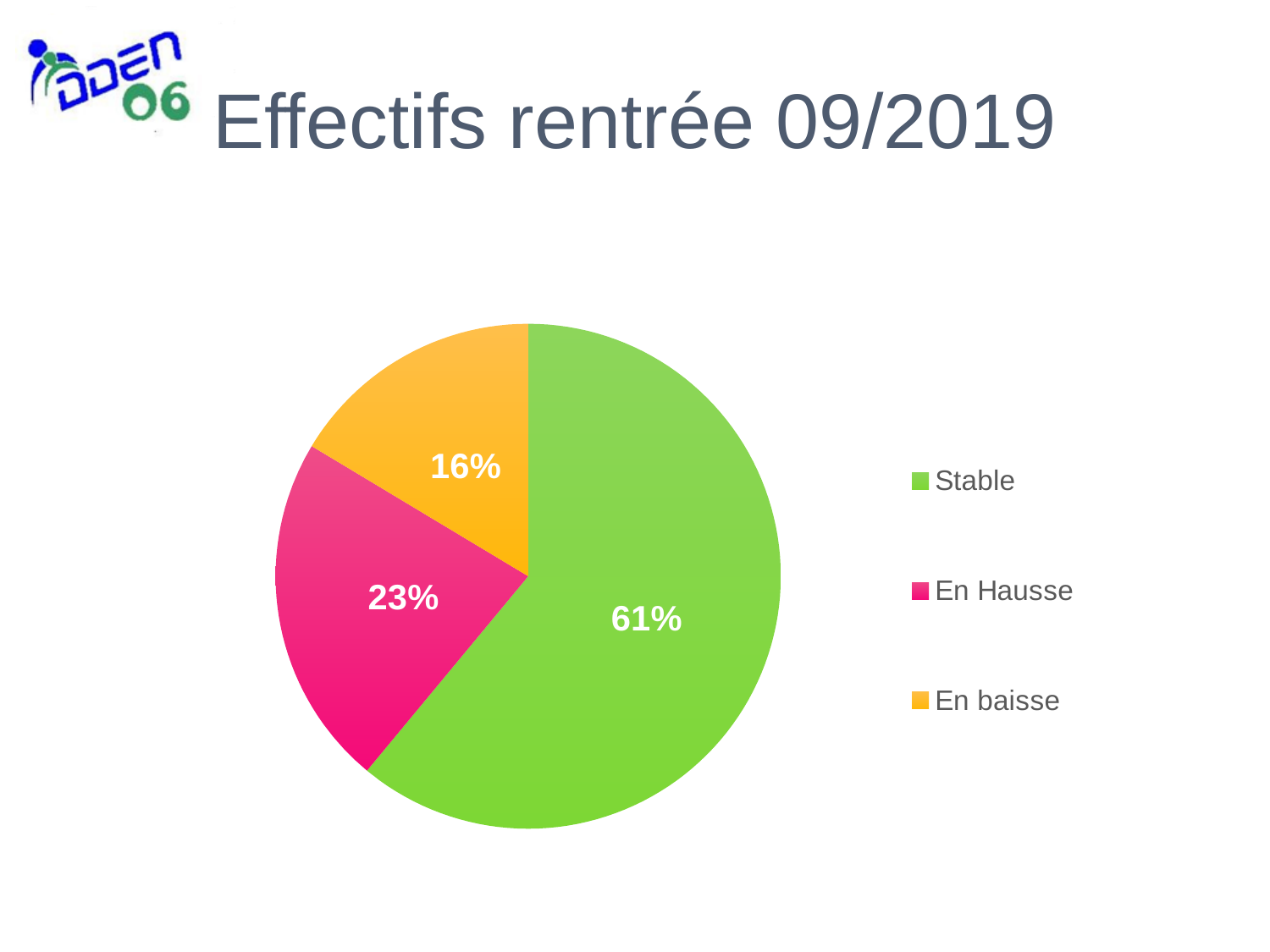
What share of the pie does the En Hausse slice represent? 23% Which is larger, the En Hausse slice or the En baisse slice? En Hausse What share of the pie does the En baisse slice represent? 16% What is the title of the slide containing the chart? Effectifs rentrée 09/2019 What kind of chart is shown on the slide? Pie chart What colour is the Stable slice in the pie chart? Green What is the difference in percentage points between the En Hausse slice and the En baisse slice? 7 Which category has the smallest slice of the pie? En baisse Which category has the largest slice of the pie? Stable What is the difference in percentage points between the Stable slice and the En Hausse slice? 38 How many categories does the pie chart show? 3 What share of the pie does the Stable slice represent? 61%